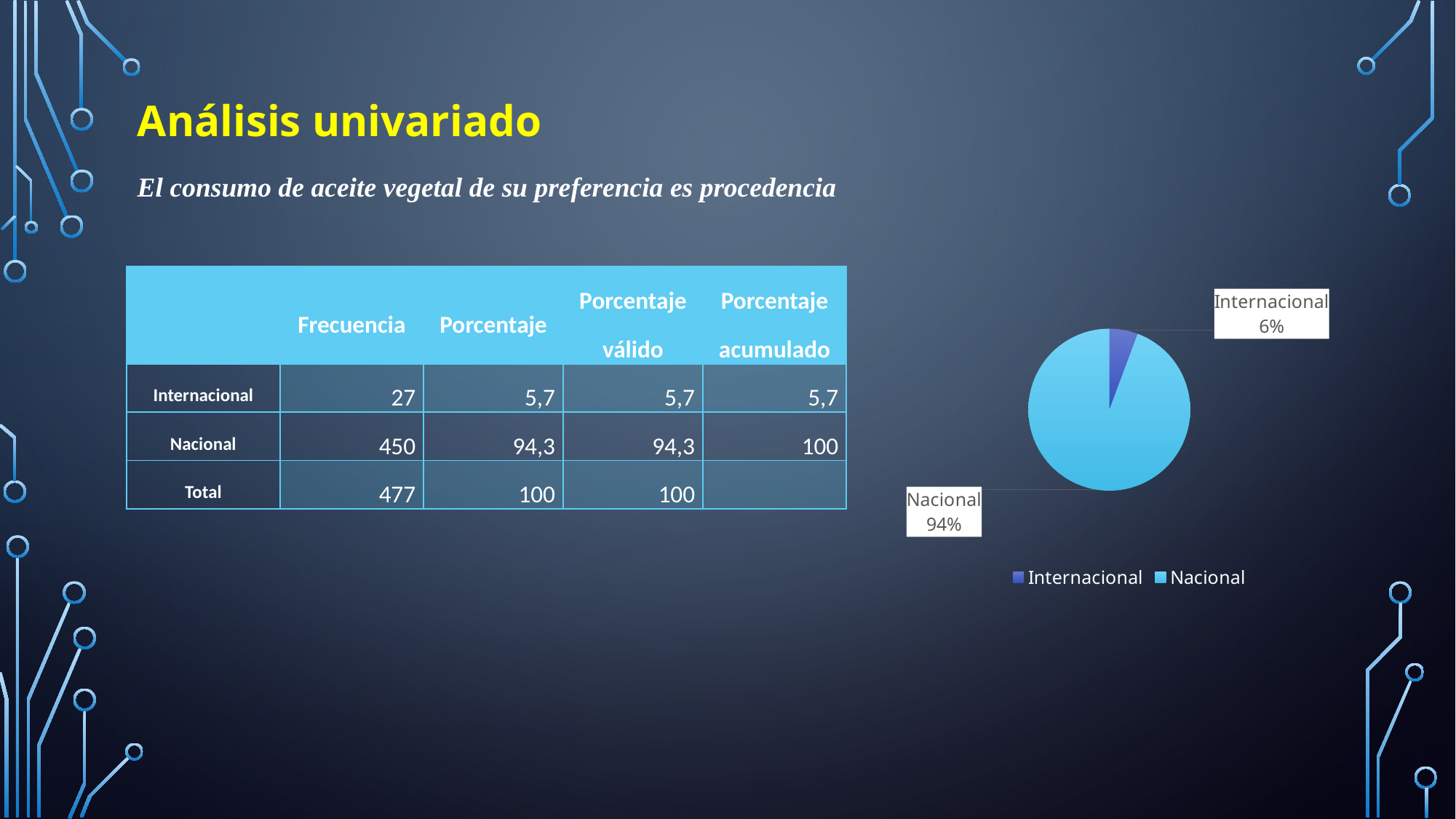
What is the value shown for the Internacional slice in the pie chart? 6% What share of the pie chart does Internacional represent? 6% What kind of chart is shown on the slide? pie chart In the pie chart, which is larger, Nacional or Internacional? Nacional How many entries does the pie chart's legend list? 2 Which legend entry in the pie chart is shown in light blue? Nacional What share of the pie chart does Nacional represent? 94% What is the difference in percentage points between the Nacional and Internacional slices of the pie chart? 88% Which slice of the pie chart is the smallest? Internacional What is the value shown for the Nacional slice in the pie chart? 94% Which slice of the pie chart is the largest? Nacional How many slices does the pie chart have? 2